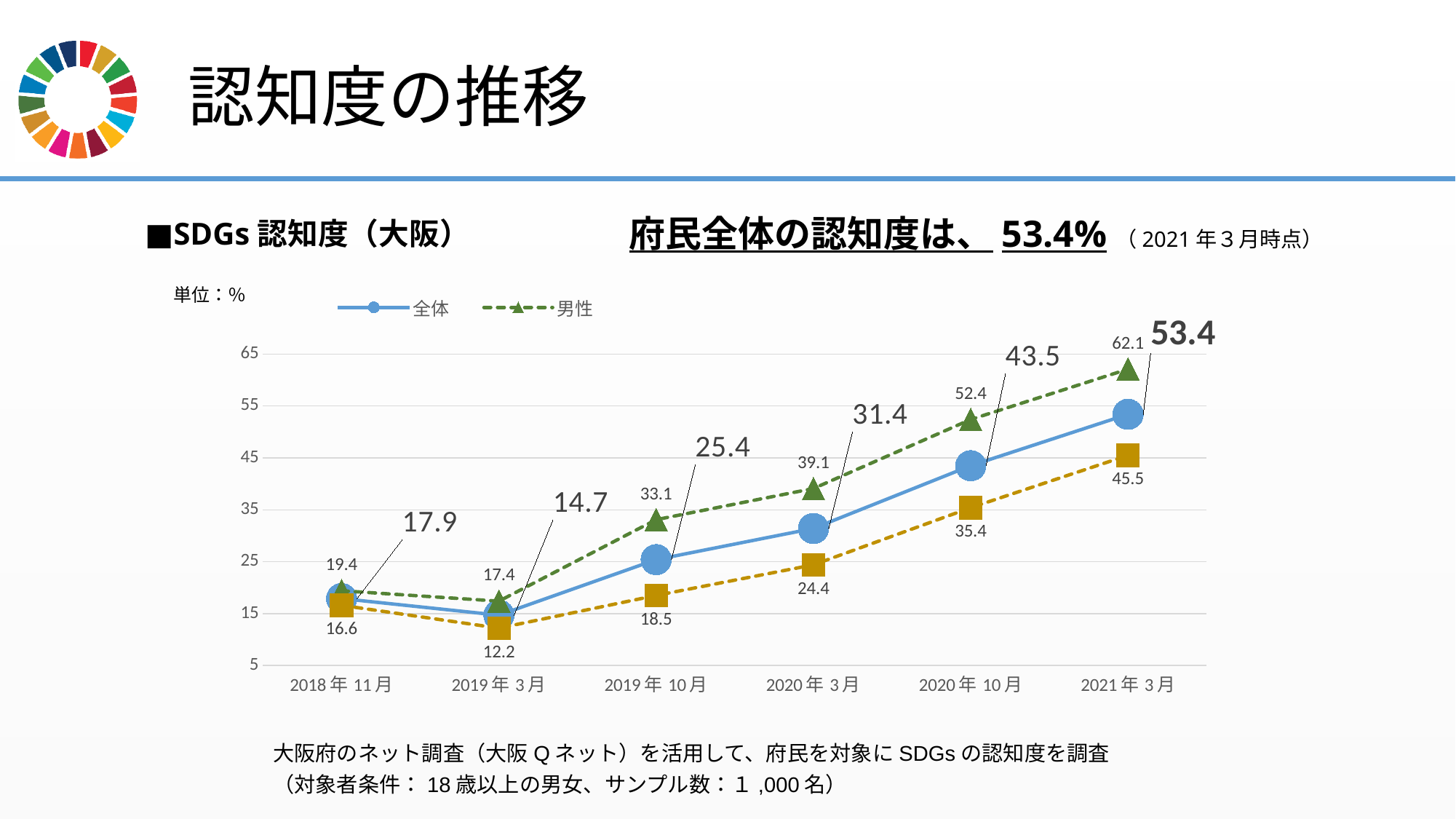
How many time periods are shown on the x axis? 6 What type of chart is shown on the slide? line chart In which period is the value for 男性 the highest? 2021年3月 Does the value for 全体 rise or fall from 2019年3月 to 2021年3月? rise What is the value for 男性 in 2019年10月? 33.1 How many series does the legend list? 2 Which is larger in 2020年3月, the value for 全体 or the value for 男性? 男性 What is the value for 全体 in 2019年3月? 14.7 What is the value for 全体 in 2021年3月? 53.4 What is the value for 男性 in 2020年10月? 52.4 In which period is the value for 全体 the lowest? 2019年3月 What is the difference between the 男性 value and the 全体 value in 2021年3月? 8.7